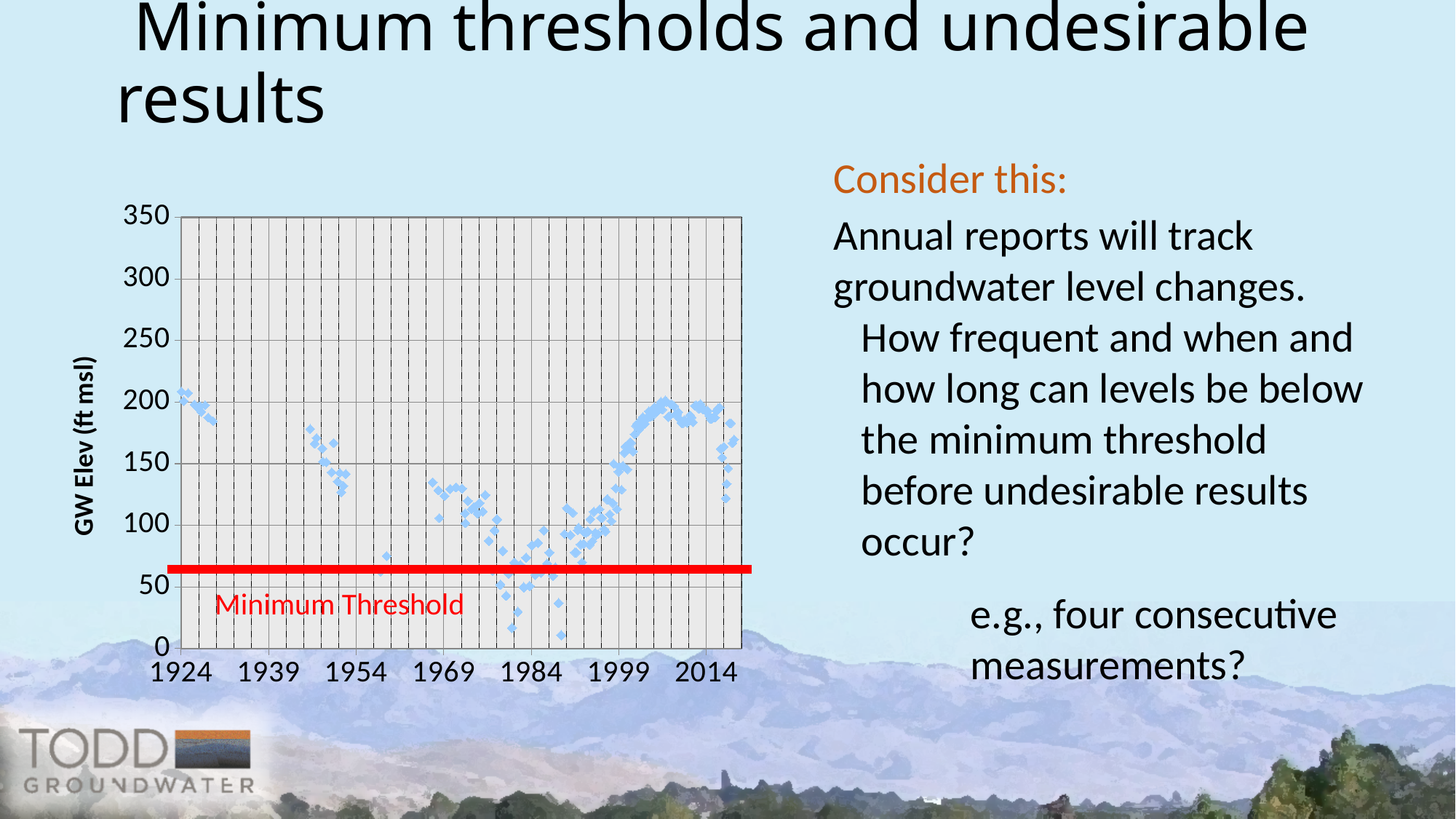
Is the Minimum Threshold line greater or less than 50 ft msl? greater Are the groundwater elevation values plotted around 1924 greater or less than 150? greater Is the Minimum Threshold line greater or less than 100 ft msl? less What is the highest value shown on the vertical axis of the chart? 350 Do the plotted groundwater elevation values rise or fall between 1924 and about 1930? fall Which is larger: the groundwater elevation around 1924 or around 1984? around 1924 What kind of chart is shown on the slide? scatter chart Do the plotted groundwater elevation values rise or fall between 1999 and about 2009? rise What is the label of the vertical axis of the chart? GW Elev (ft msl) What is the label on the red horizontal line in the chart? Minimum Threshold